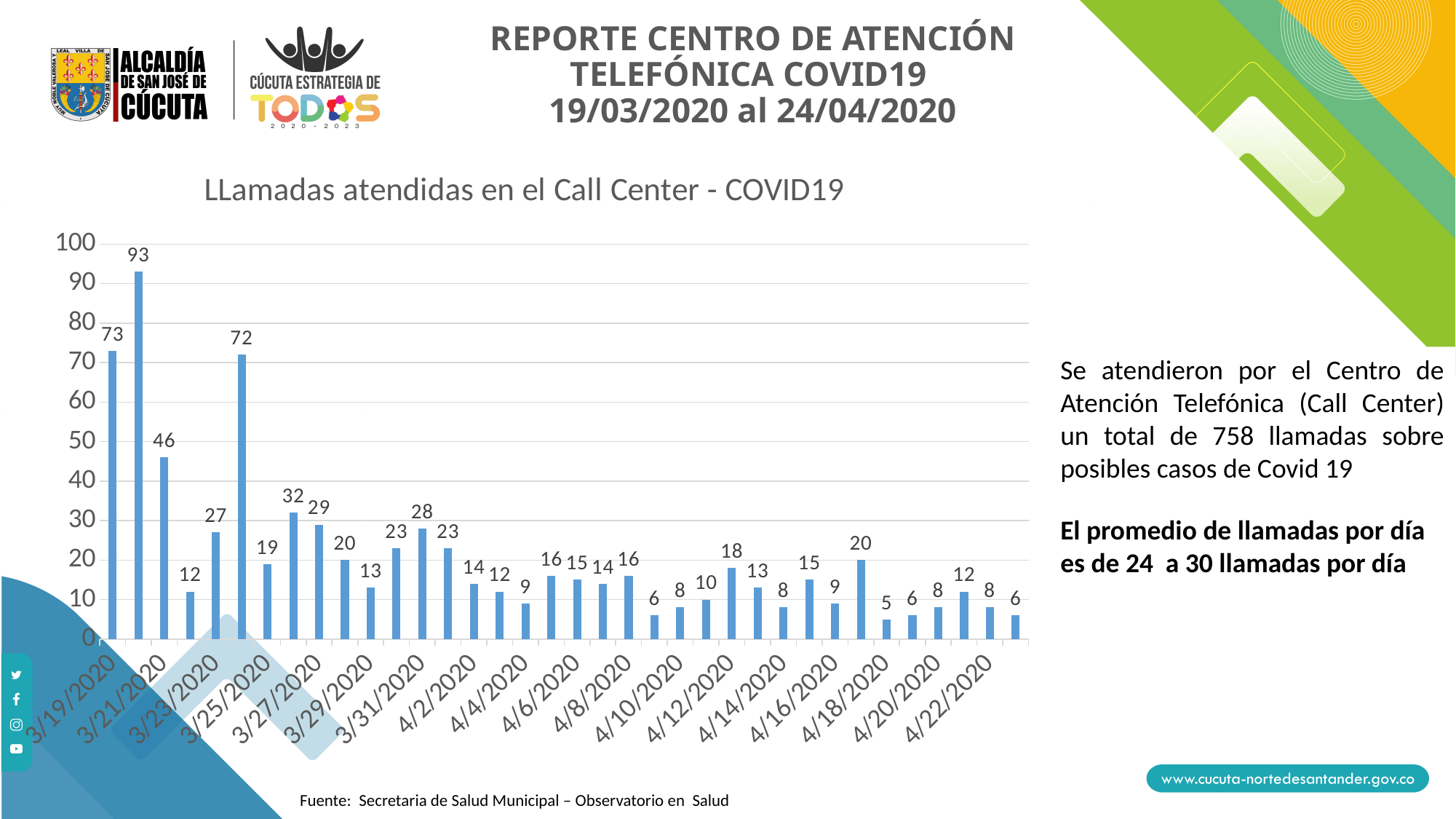
What is the highest value shown in the chart? 93 Do the number of calls generally rise or fall from 3/19/2020 to 4/22/2020? fall What is the difference between the calls on 3/19/2020 and 3/21/2020? 27 How many calls were attended on 4/12/2020? 18 Which labeled date has the lowest number of calls? 4/18/2020 How many calls were attended on 3/21/2020? 46 Which date had more calls, 3/27/2020 or 3/31/2020? 3/27/2020 How many calls were attended on 4/18/2020? 5 What is the title of the chart? LLamadas atendidas en el Call Center - COVID19 Is the value for 3/23/2020 greater or less than 20? greater How many calls were attended on 3/19/2020? 73 What type of chart is shown on the slide? bar chart